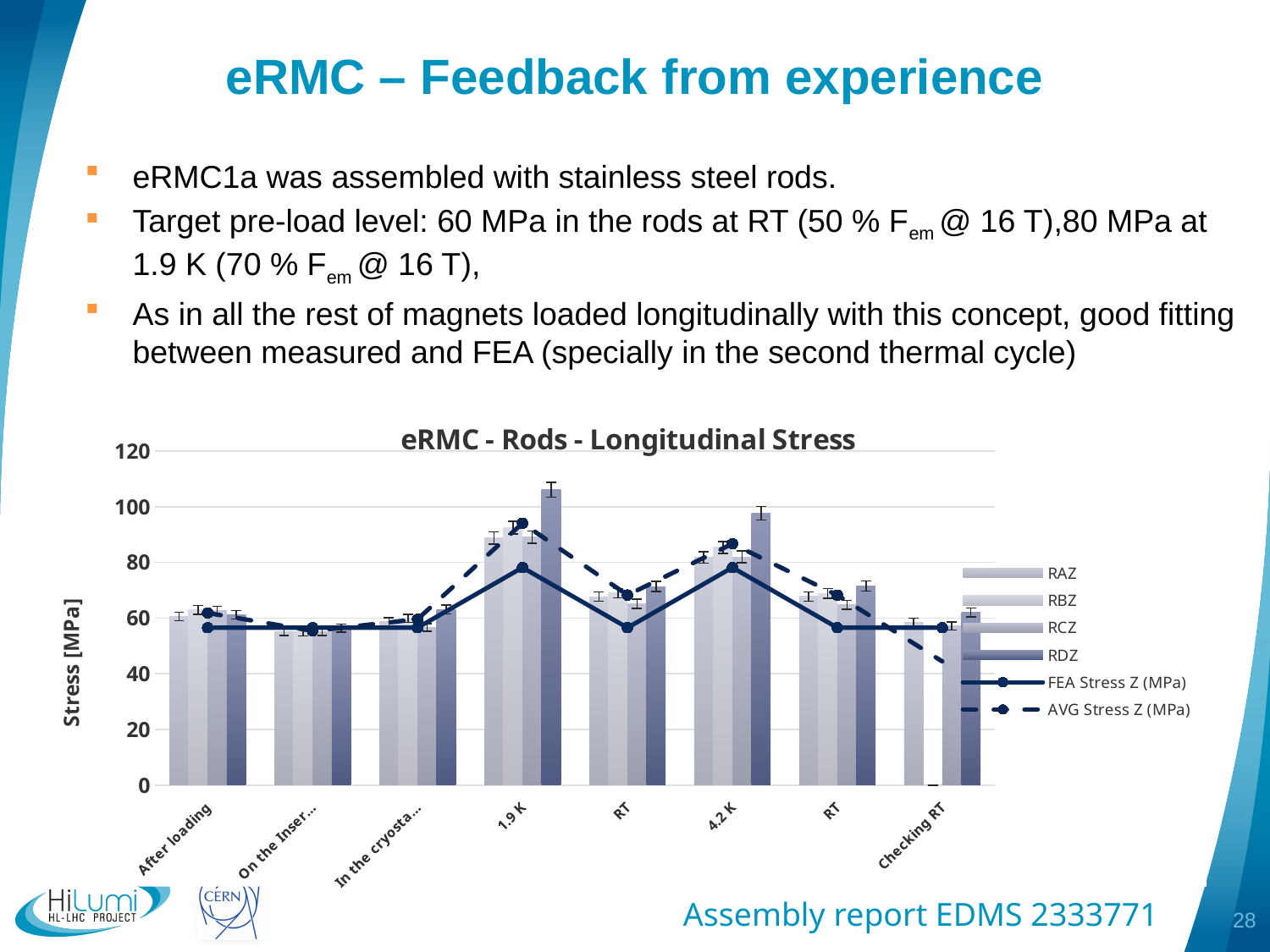
In the 'eRMC - Rods - Longitudinal Stress' chart, is the FEA Stress Z value at 1.9 K greater or less than 60? greater What is the title of the chart on the slide? eRMC - Rods - Longitudinal Stress In the 'eRMC - Rods - Longitudinal Stress' chart, is the RDZ value larger at 1.9 K or at 4.2 K? 1.9 K How many series does the legend of the 'eRMC - Rods - Longitudinal Stress' chart list? 6 In the 'eRMC - Rods - Longitudinal Stress' chart, is the RDZ value at 4.2 K greater or less than 80? greater In the 'eRMC - Rods - Longitudinal Stress' chart, do the RDZ values rise or fall from 'In the cryosta...' to '1.9 K'? rise In the 'eRMC - Rods - Longitudinal Stress' chart, at which category does the RDZ series reach its highest value? 1.9 K What is the label of the y axis of the 'eRMC - Rods - Longitudinal Stress' chart? Stress [MPa] In the 'eRMC - Rods - Longitudinal Stress' chart, is the RAZ value at 'After loading' greater or less than 80? less What kind of chart is 'eRMC - Rods - Longitudinal Stress'? Bar chart with line series How many categories are shown on the x axis of the 'eRMC - Rods - Longitudinal Stress' chart? 8